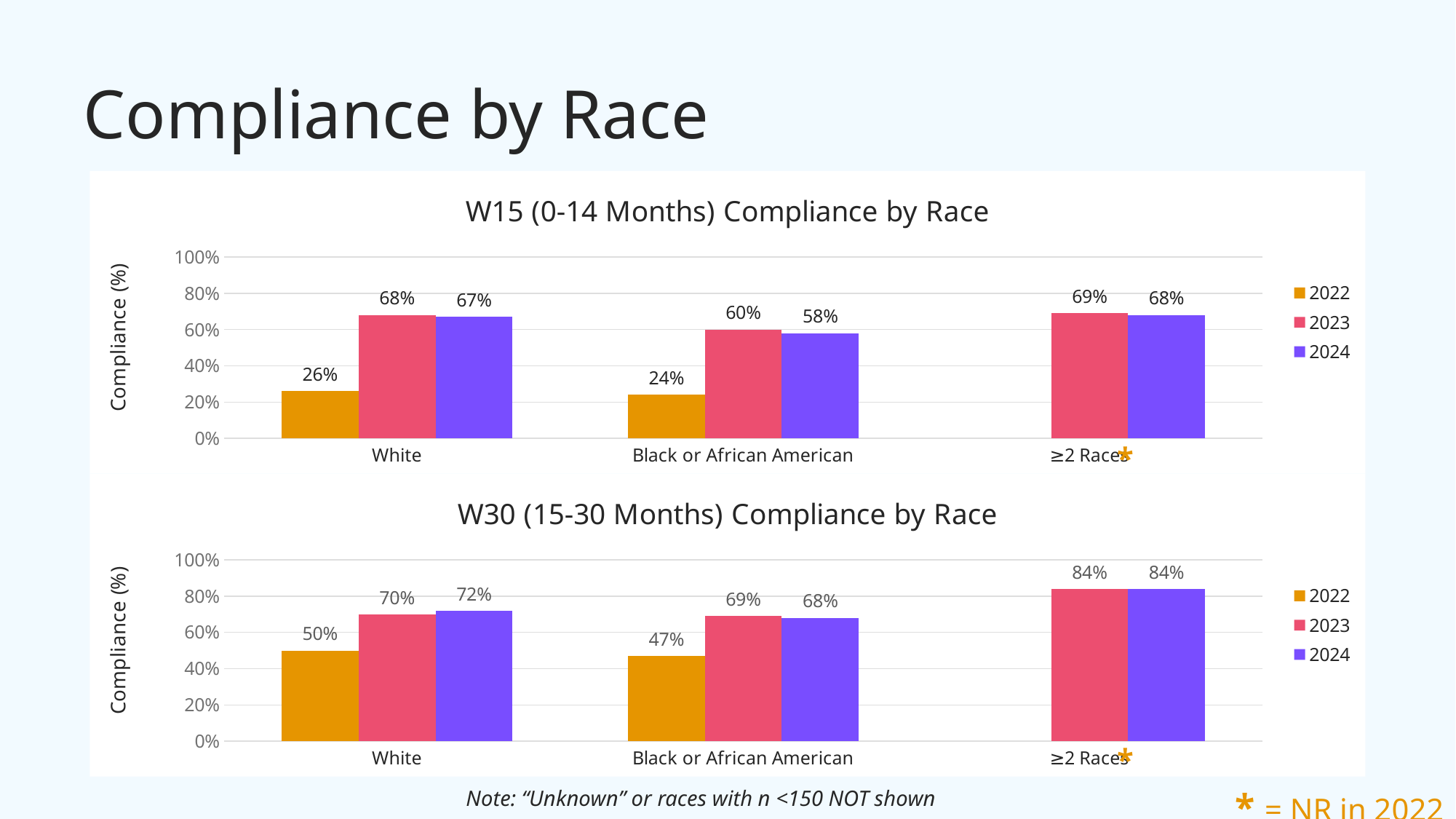
In the W30 (15-30 Months) Compliance by Race chart, what is the difference between the 2024 values for White and Black or African American? 4% In the W30 (15-30 Months) Compliance by Race chart, what is the 2022 value for Black or African American? 47% In the W15 (0-14 Months) Compliance by Race chart, what is the difference between the 2023 and 2022 values for White? 42% In the W30 (15-30 Months) Compliance by Race chart, which is larger for White: the 2023 value or the 2024 value? 2024 In the W30 (15-30 Months) Compliance by Race chart, which category has the highest 2024 value? ≥2 Races What kind of chart is the W15 (0-14 Months) Compliance by Race chart? Bar chart In the W30 (15-30 Months) Compliance by Race chart, what does the asterisk next to ≥2 Races indicate? NR in 2022 In the W15 (0-14 Months) Compliance by Race chart, what is the 2024 value for ≥2 Races? 68% In the W15 (0-14 Months) Compliance by Race chart, what is the 2023 value for White? 68% How many series does the legend of the W15 (0-14 Months) Compliance by Race chart list? 3 In the W15 (0-14 Months) Compliance by Race chart, which category has the lowest 2022 value? Black or African American How many race categories are shown on the x axis of the W30 (15-30 Months) Compliance by Race chart? 3